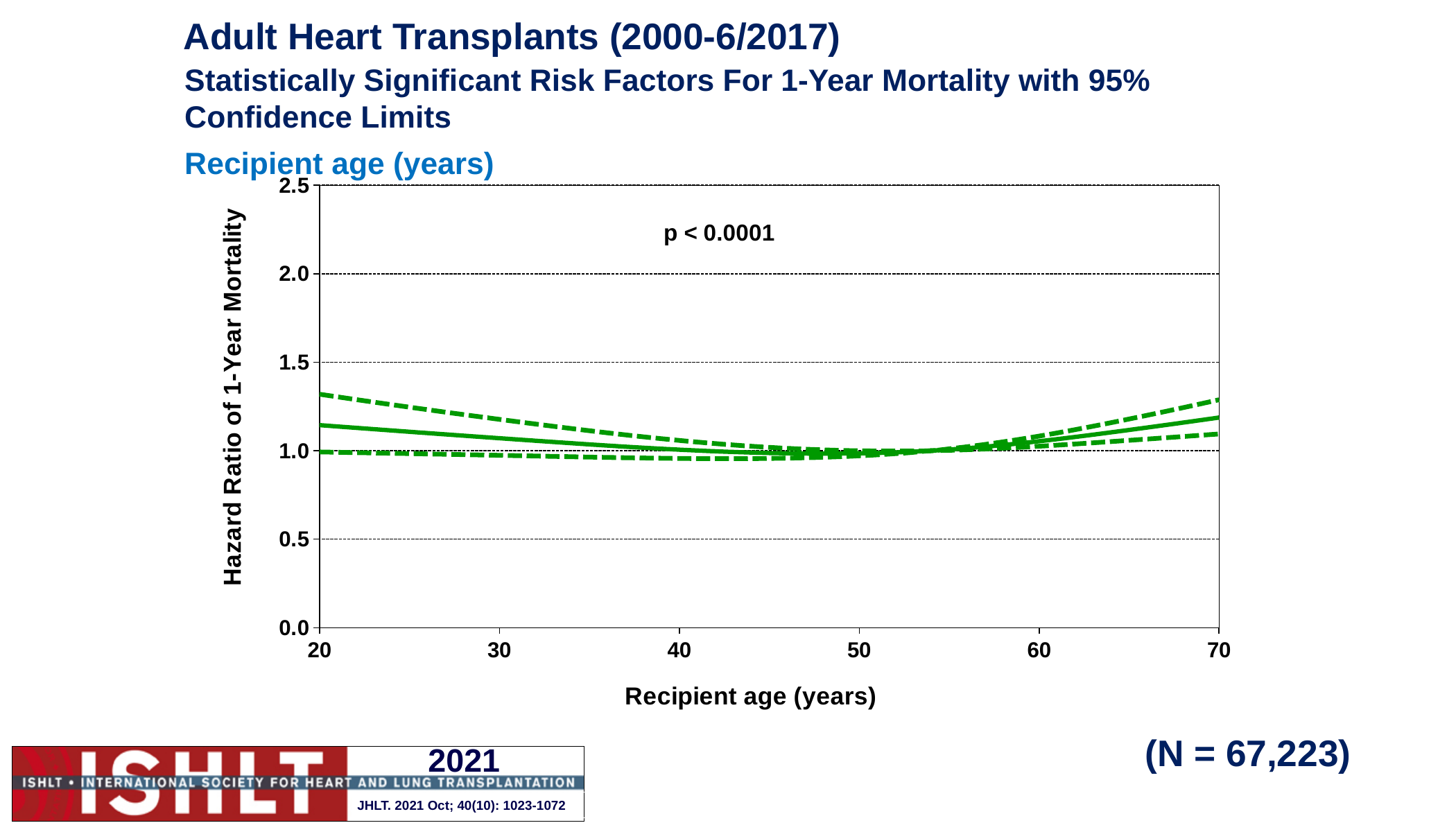
Is the hazard ratio of the solid line at recipient age 20 greater or less than 1.0? greater What is the sample size (N) shown on the slide? 67,223 What kind of chart is shown on the slide? line chart Is the upper dashed confidence limit at recipient age 20 greater or less than 1.5? less What is the label of the x axis of the chart? Recipient age (years) Is the hazard ratio of the solid line at recipient age 70 greater or less than 1.5? less Does the solid hazard ratio line rise or fall as recipient age increases from 55 to 70? rise What is the highest value shown on the y axis of the chart? 2.5 What p-value is printed on the chart? p < 0.0001 What is the label of the y axis of the chart? Hazard Ratio of 1-Year Mortality How many lines are plotted on the chart? 3 Does the solid hazard ratio line rise or fall as recipient age increases from 20 to 50? fall